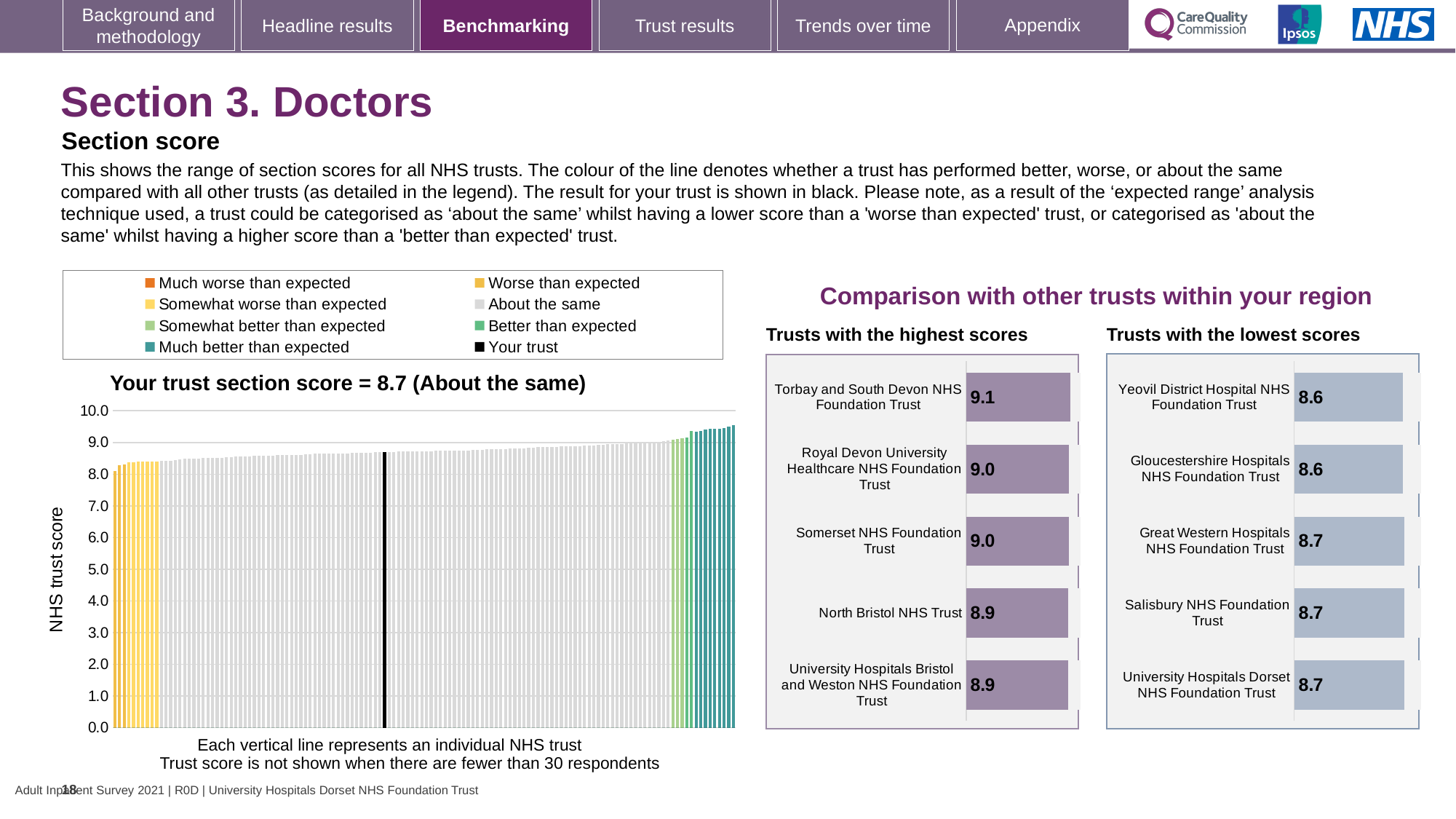
How many entries does the legend above the main chart on the left list? 8 In the 'Trusts with the highest scores' chart, what is the difference between the scores of Torbay and South Devon NHS Foundation Trust and North Bristol NHS Trust? 0.2 In the 'Trusts with the highest scores' chart, which has the larger score: Torbay and South Devon NHS Foundation Trust or Somerset NHS Foundation Trust? Torbay and South Devon NHS Foundation Trust What is the section score for your trust shown in the title of the main chart on the left? 8.7 In the 'Trusts with the lowest scores' chart, what is the score for Yeovil District Hospital NHS Foundation Trust? 8.6 How many trusts are listed in the 'Trusts with the lowest scores' chart? 5 In the 'Trusts with the highest scores' chart, what is the score for North Bristol NHS Trust? 8.9 What kind of chart is the main chart on the left showing the range of section scores? Bar chart In the 'Trusts with the lowest scores' chart, what is the score for University Hospitals Dorset NHS Foundation Trust? 8.7 In the 'Trusts with the highest scores' chart, what is the score for Torbay and South Devon NHS Foundation Trust? 9.1 In the main chart on the left, do the trust scores rise or fall from left to right along the x axis? Rise In the 'Trusts with the highest scores' chart, which trust has the highest score? Torbay and South Devon NHS Foundation Trust